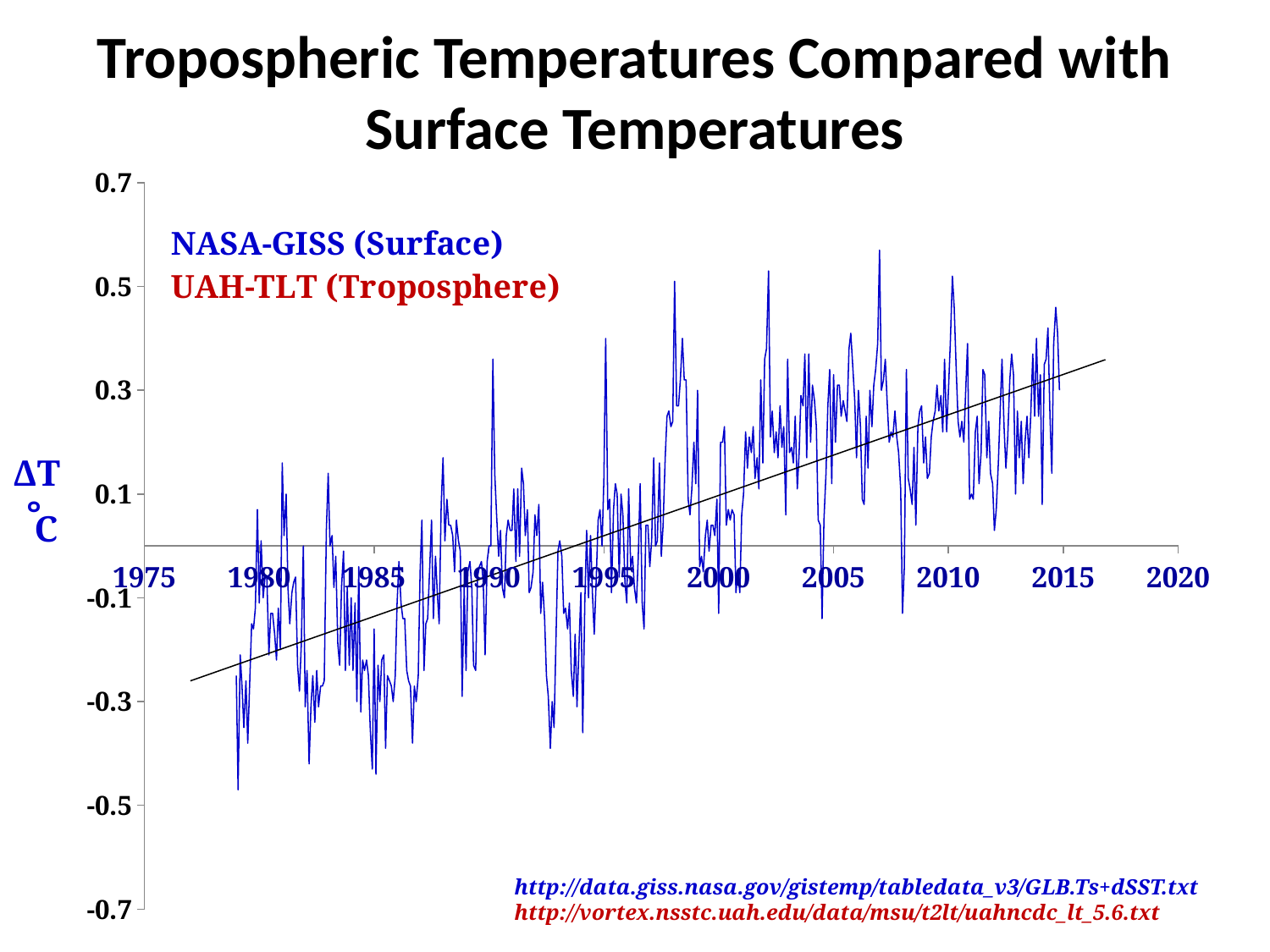
What is the label on the y axis? ΔT °C Is the value of the black trend line at its left end (around 1977) greater or less than -0.1? less How many series does the legend list? 2 What is the title of the chart? Tropospheric Temperatures Compared with Surface Temperatures What kind of chart is shown on the slide? Line chart Is the highest peak of the blue line, around 2007, greater or less than 0.5? greater Is the lowest point of the blue line, around 1979, greater or less than -0.3? less What is the highest value shown on the y axis? 0.7 Does the temperature anomaly generally rise or fall from 1975 to 2015 along the x axis? Rise Which is larger: the blue line's peak around 1998 or its peak around 1983? The peak around 1998